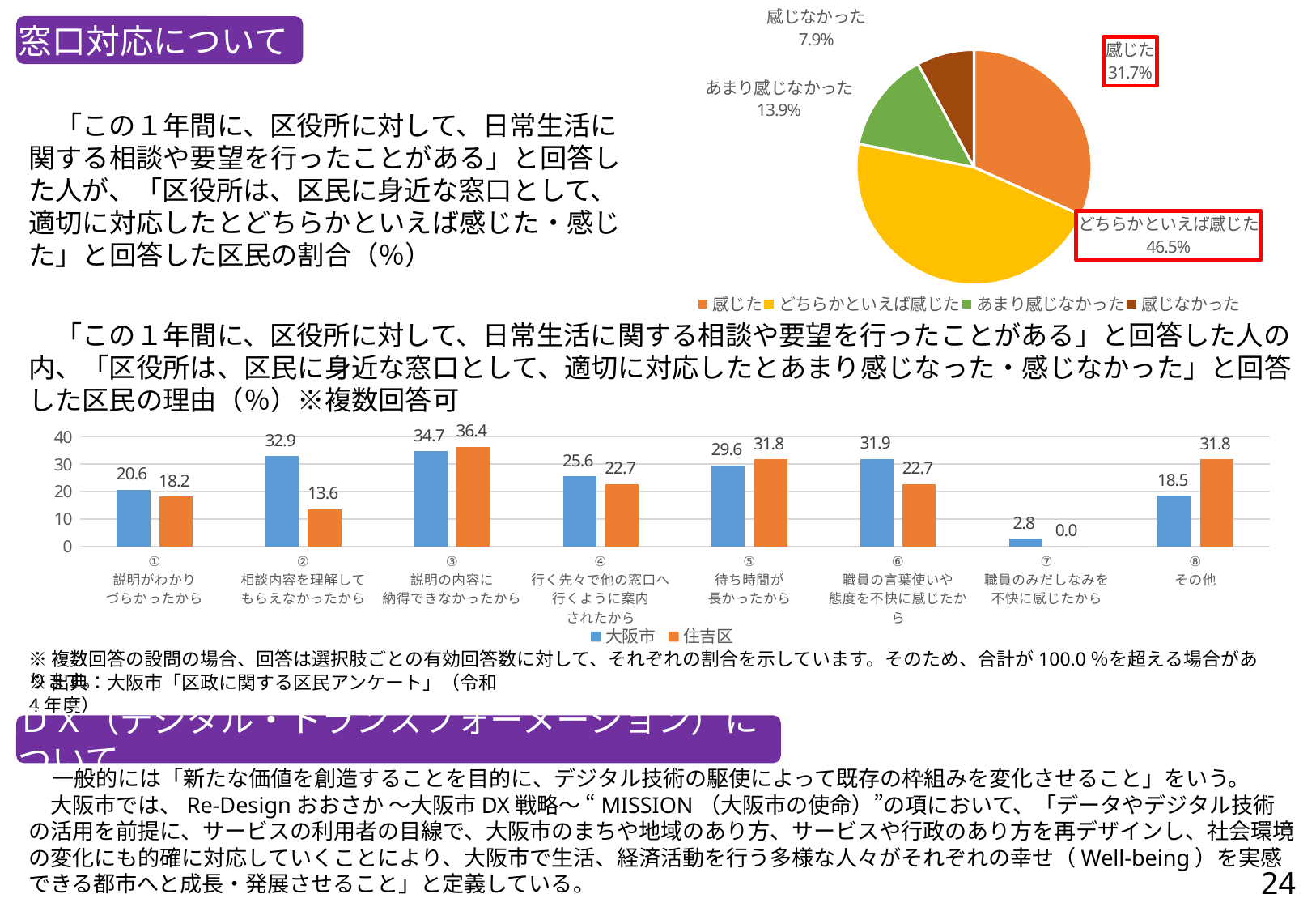
In the bar chart at the bottom, what is the value for 大阪市 in category ⑥? 31.9 In the pie chart at the top right, which category has the smallest slice? 感じなかった In the bar chart at the bottom, which is larger in category ⑧, 大阪市 or 住吉区? 住吉区 In the bar chart at the bottom, which category has the lowest value for 大阪市? ⑦ In the bar chart at the bottom, what is the difference between 大阪市 and 住吉区 in category ②? 19.3 In the bar chart at the bottom, which category has the highest value for 住吉区? ③ In the pie chart at the top right, how many categories does the legend list? 4 In the bar chart at the bottom, how many series does the legend list? 2 In the pie chart at the top right, which category has the largest slice? どちらかといえば感じた In the bar chart at the bottom, what is the value for 住吉区 in category ②? 13.6 In the pie chart at the top right, what share is labelled for どちらかといえば感じた? 46.5% In the pie chart at the top right, what share is labelled for 感じなかった? 7.9%